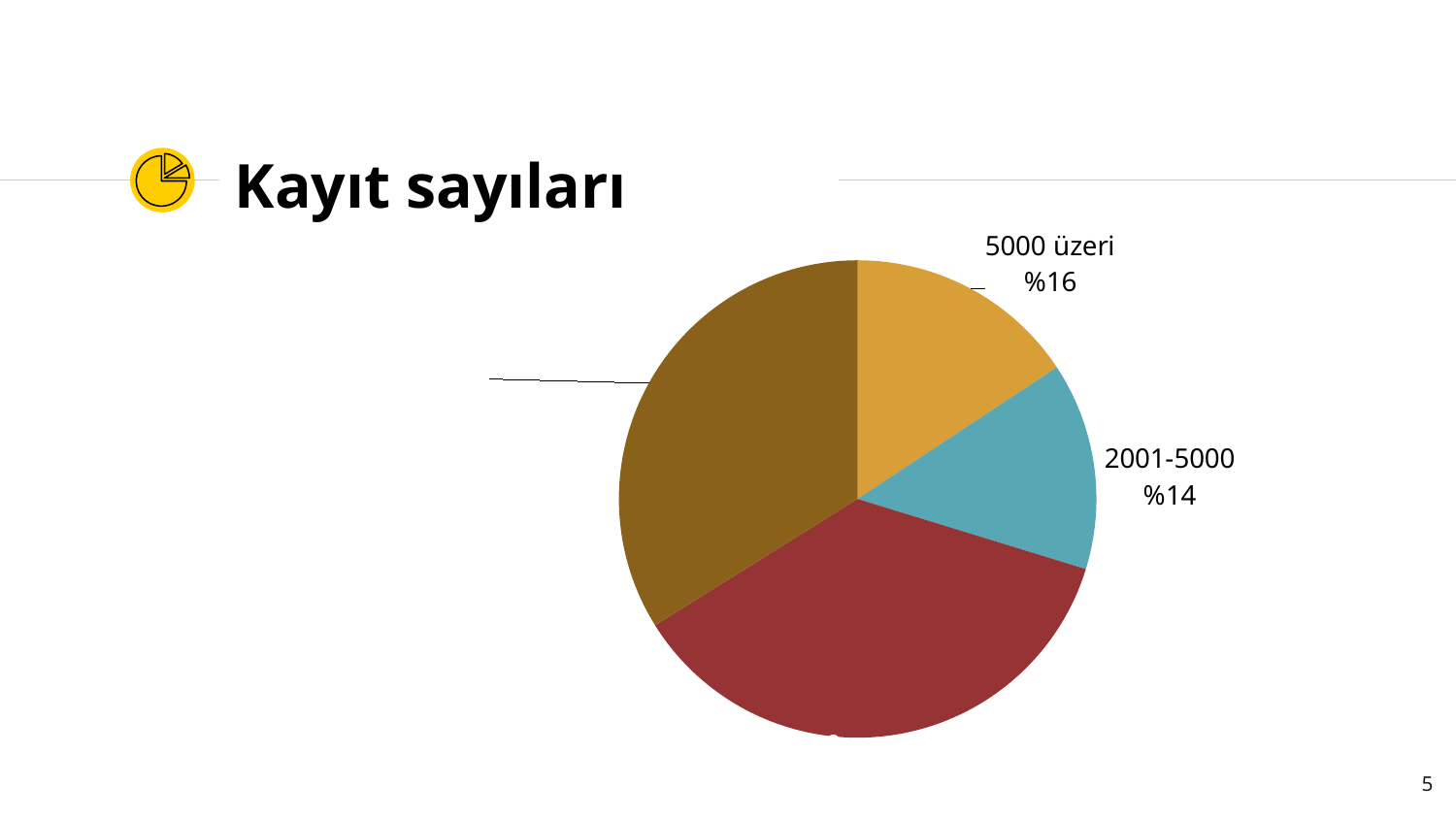
What share of the pie does the "2001-5000" slice represent? %14 Which slice is larger, "5000 üzeri" or "2001-5000"? 5000 üzeri What kind of chart is shown on the slide? pie chart What share of the pie does the "5000 üzeri" slice represent? %16 What colour is the "2001-5000" slice of the pie chart? teal What is the difference between the shares of "5000 üzeri" and "2001-5000"? %2 How many slices does the pie chart have? 4 What is the title of the slide containing the pie chart? Kayıt sayıları